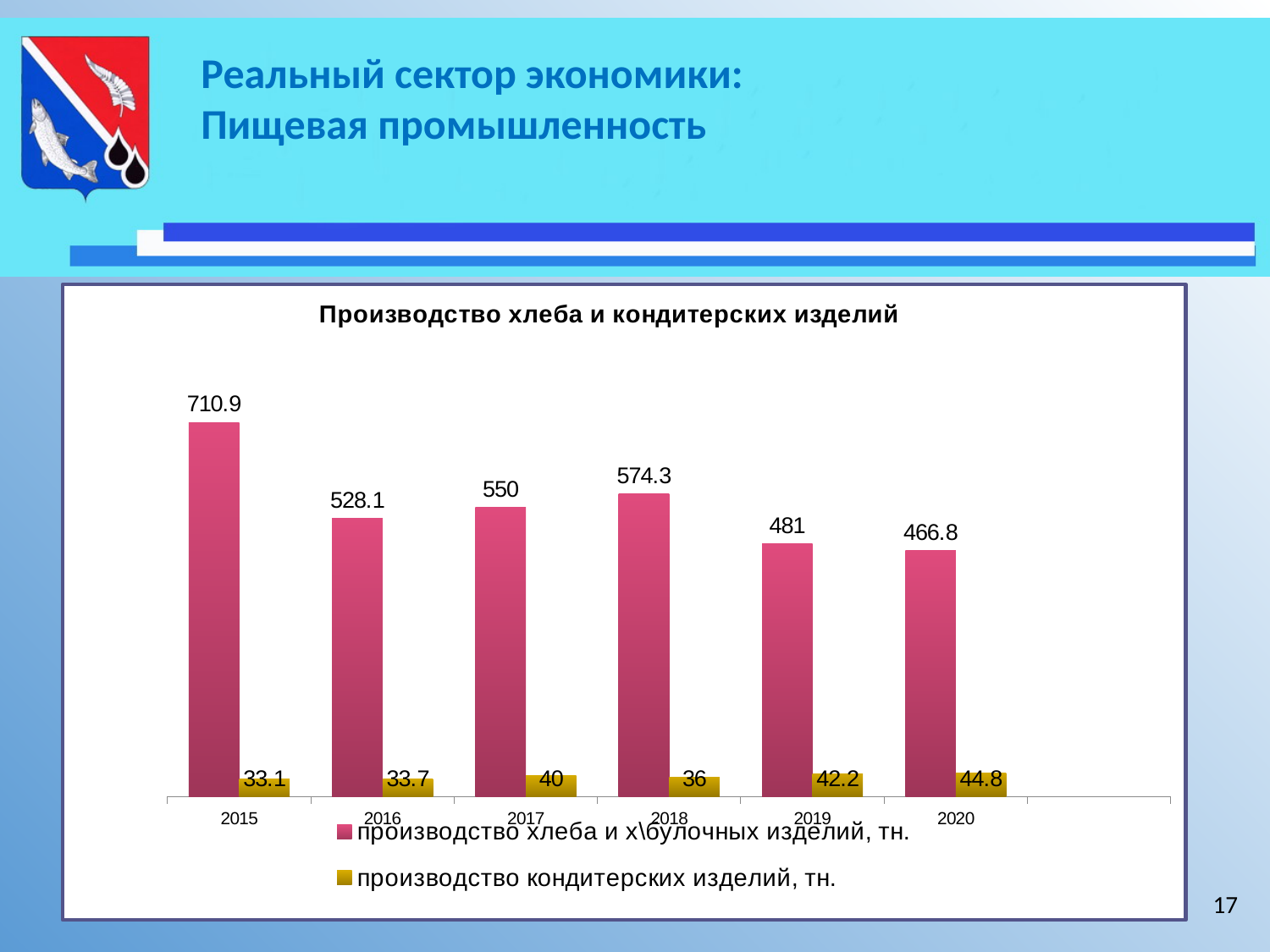
How many series does the legend list? 2 What is the title of the chart? Производство хлеба и кондитерских изделий Which year has the lowest value for производство кондитерских изделий, тн.? 2015 Does производство хлеба и х\булочных изделий, тн. rise or fall from 2018 to 2020? fall What is the value for производство хлеба и х\булочных изделий, тн. in 2015? 710.9 Which is larger: производство кондитерских изделий, тн. in 2017 or in 2018? 2017 What is the difference between the 2015 and 2020 values for производство хлеба и х\булочных изделий, тн.? 244.1 Which year has the highest value for производство хлеба и х\булочных изделий, тн.? 2015 What kind of chart is shown? bar chart How many years are shown on the x axis? 6 What is the value for производство хлеба и х\булочных изделий, тн. in 2018? 574.3 What is the value for производство кондитерских изделий, тн. in 2020? 44.8